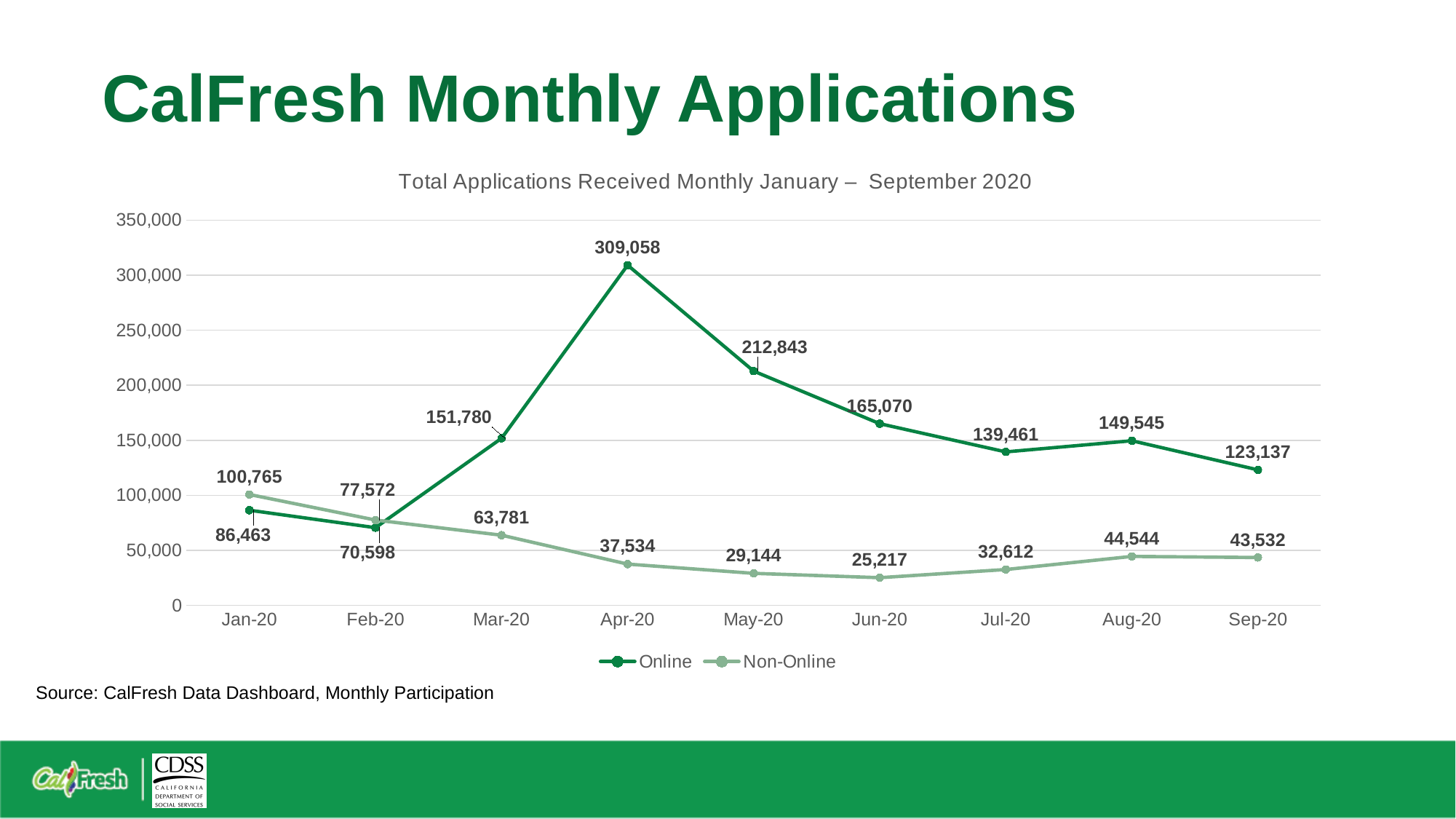
In which month was the Non-Online series lowest? Jun-20 In Jan-20, which series had the larger value, Online or Non-Online? Non-Online In which month was the Online series highest? Apr-20 How many months are plotted on the x axis? 9 What was the Online value in Sep-20? 123,137 What kind of chart is shown on the slide? line chart Is the Online value for May-20 greater or less than 200,000? greater How many series does the legend list? 2 What was the Online value in Apr-20? 309,058 What was the Non-Online value in Jun-20? 25,217 What is the difference between the Online and Non-Online values in Apr-20? 271,524 In which month was the Online series lowest? Feb-20